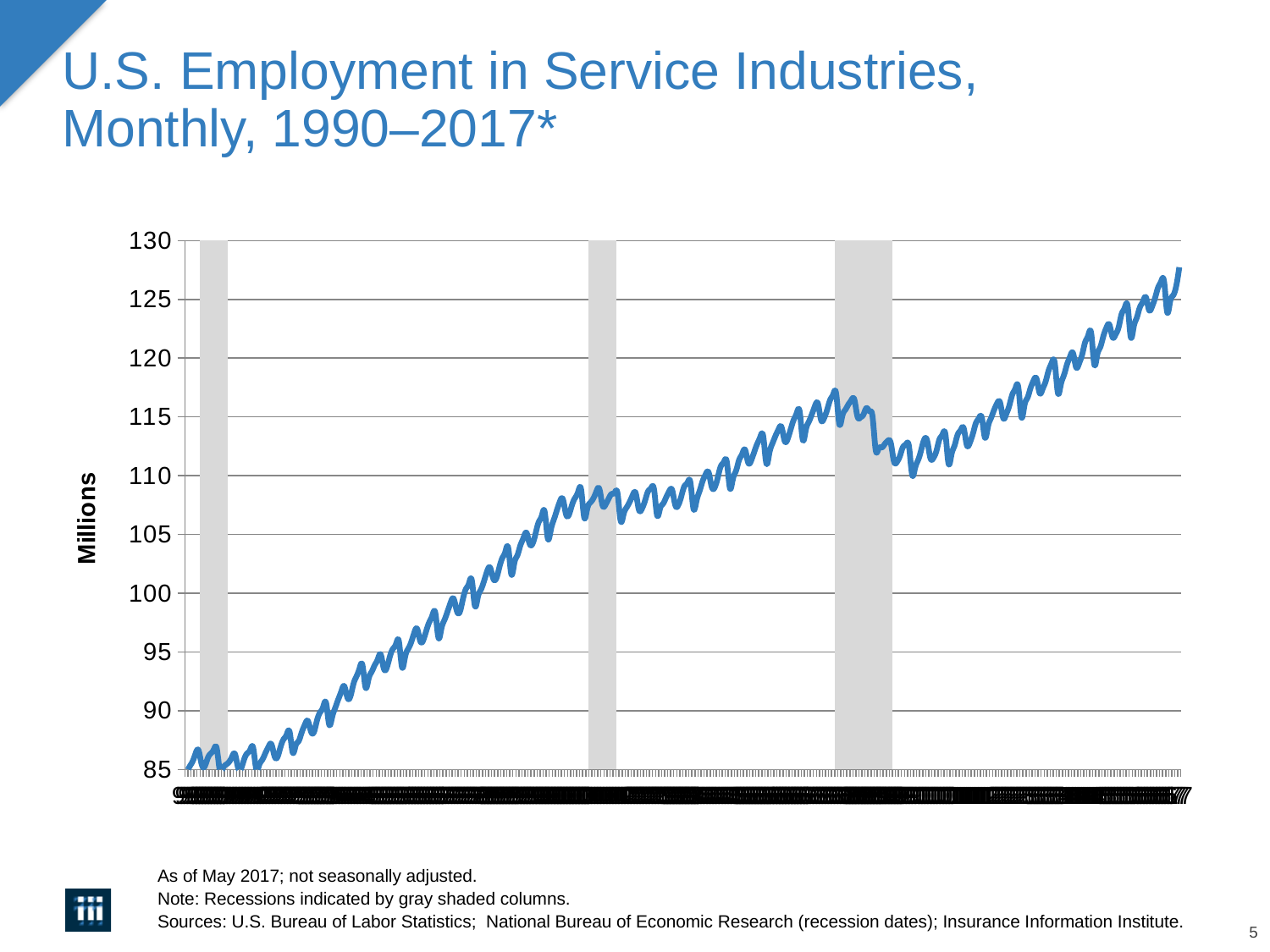
What is the label on the vertical axis of the chart? Millions Is the highest point of the line greater or less than 130? less What kind of chart is shown on the slide? line chart Is the value at the right end of the line (the most recent point) greater or less than 125? greater Do the values in the chart generally rise or fall from left to right along the x axis? rise Is the value at the left end of the line (the earliest point) greater or less than 90? less How many gray shaded recession columns appear on the chart? 3